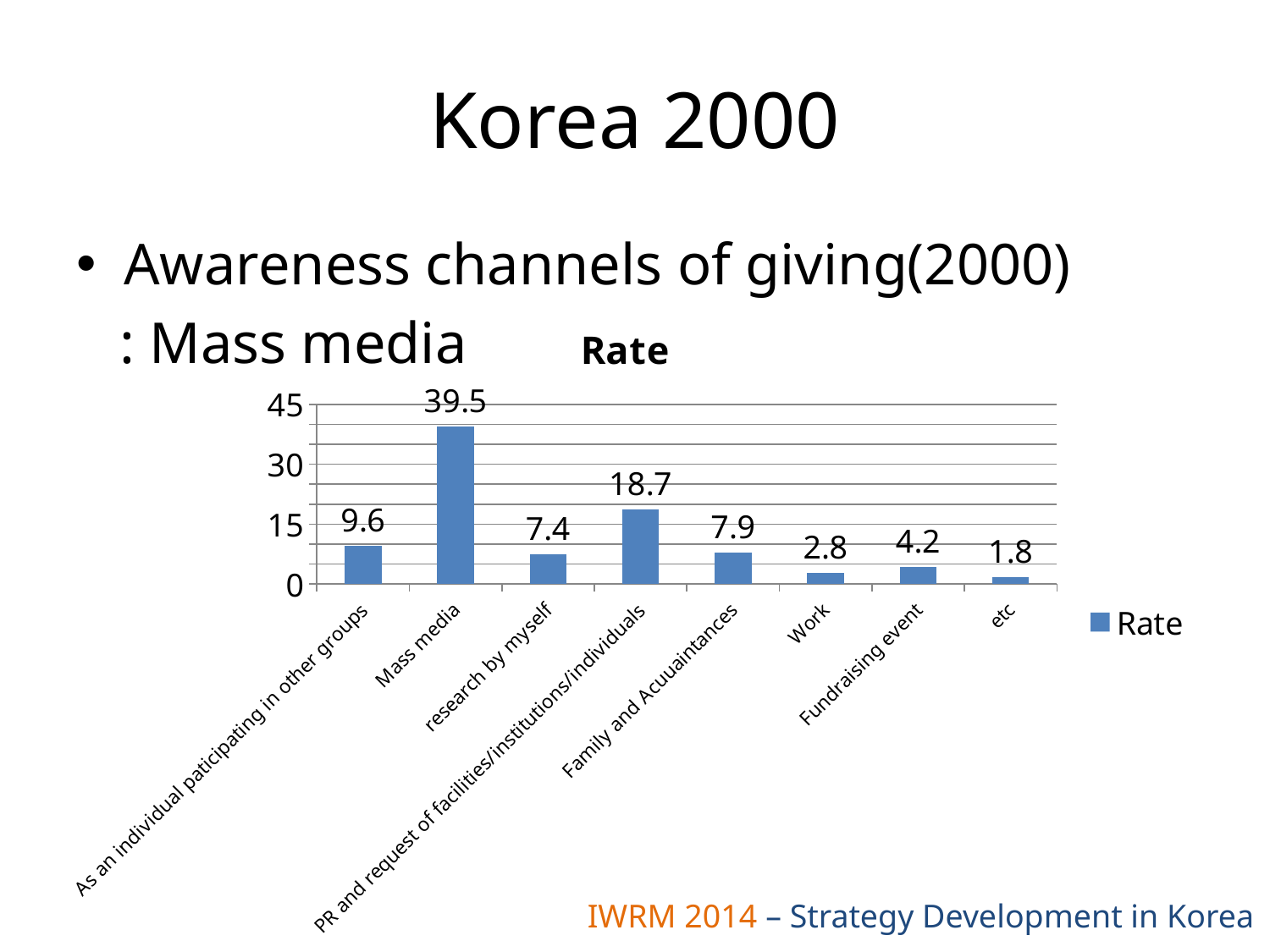
Is the Rate for PR and request of facilities/institutions/individuals greater or less than 15? greater How many series does the legend list? 1 What is the Rate value for Mass media? 39.5 What is the difference between the Rate for Mass media and the Rate for PR and request of facilities/institutions/individuals? 20.8 What kind of chart is shown on the slide? Bar chart Which has a higher Rate: research by myself or Family and Acuuaintances? Family and Acuuaintances What is the title of the chart? Rate What is the Rate value for Family and Acuuaintances? 7.9 How many categories are shown on the x axis of the chart? 8 Which category has the highest Rate? Mass media What is the Rate value for Fundraising event? 4.2 Which category has the lowest Rate? etc